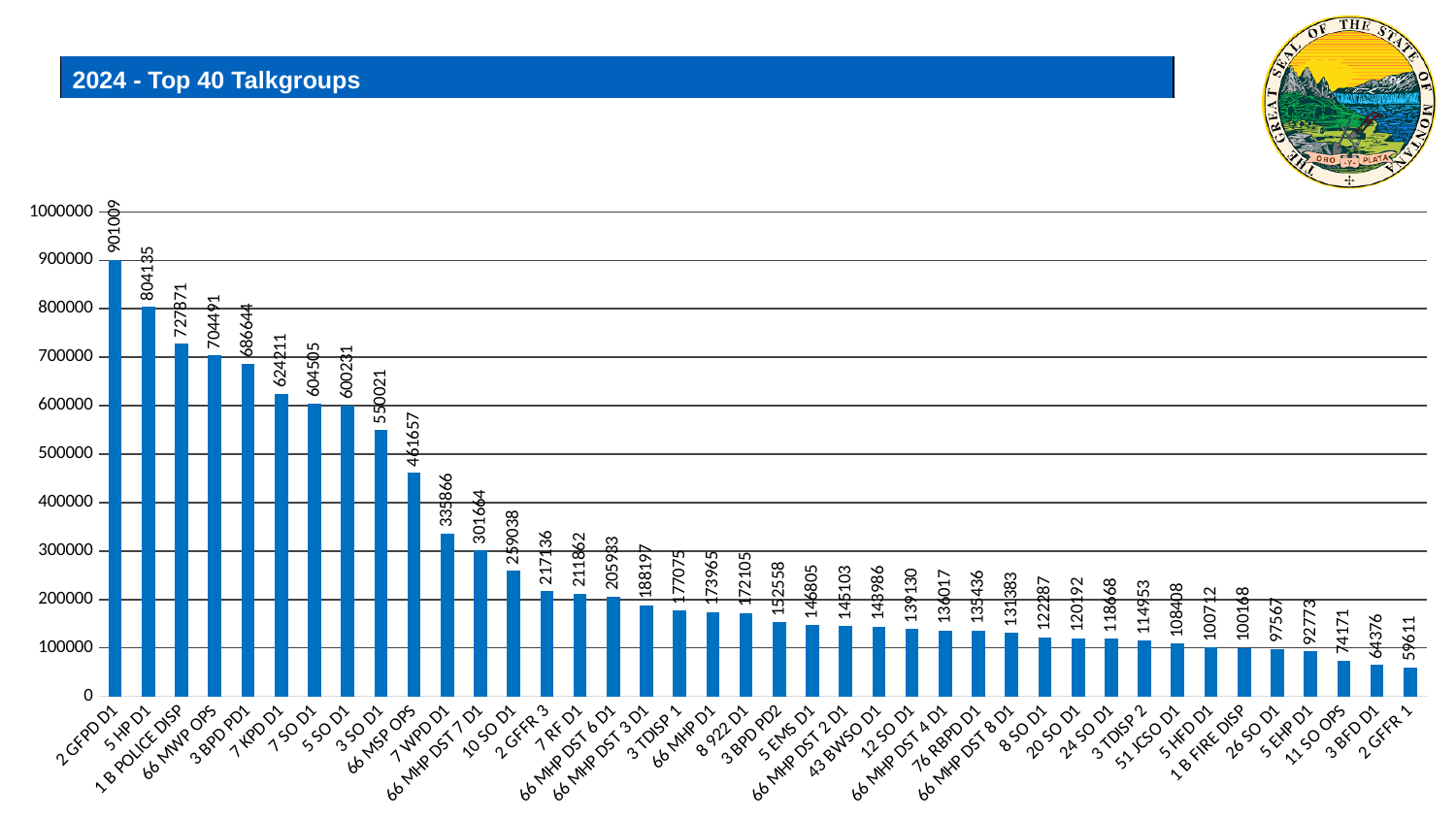
What is the difference between the values for 5 HP D1 and 1 B POLICE DISP? 76264 Is the value for 3 SO D1 greater or less than 500000? greater What is the value for 2 GFPD D1? 901009 What is the title of the slide? 2024 - Top 40 Talkgroups Which talkgroup has the highest value? 2 GFPD D1 What is the value for 3 BPD PD2? 152558 What is the value for 66 MSP OPS? 461657 What kind of chart is shown on the slide? bar chart How many talkgroups are shown on the chart? 40 Which talkgroup has the lowest value? 2 GFFR 1 Do the values rise or fall from left to right along the x axis? fall Which is larger, the value for 7 WPD D1 or the value for 10 SO D1? 7 WPD D1